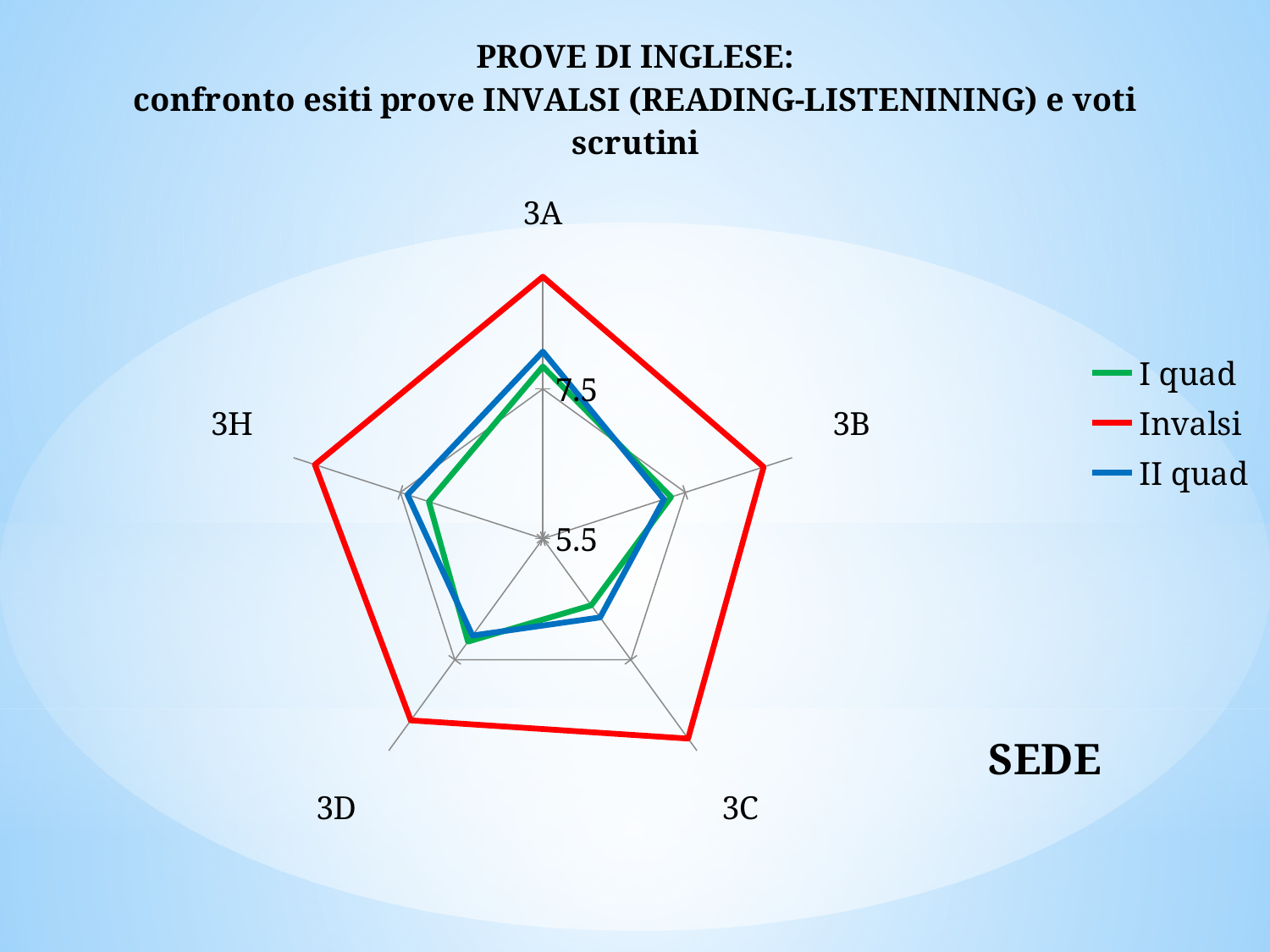
For class 3A, which series has the higher value, Invalsi or I quad? Invalsi How many categories (classes) are plotted on the radar chart? 5 Which series is shown in green in the legend? I quad What kind of chart is shown on the slide? radar chart For class 3A, which series has the higher value, I quad or II quad? II quad Is the Invalsi value for 3H greater or less than 7.5? greater For class 3C, which series has the higher value, I quad or II quad? II quad Is the Invalsi value for 3A greater or less than 7.5? greater How many series does the legend list? 3 Which series is shown in red in the legend? Invalsi Is the Invalsi value for 3C greater or less than 7.5? greater